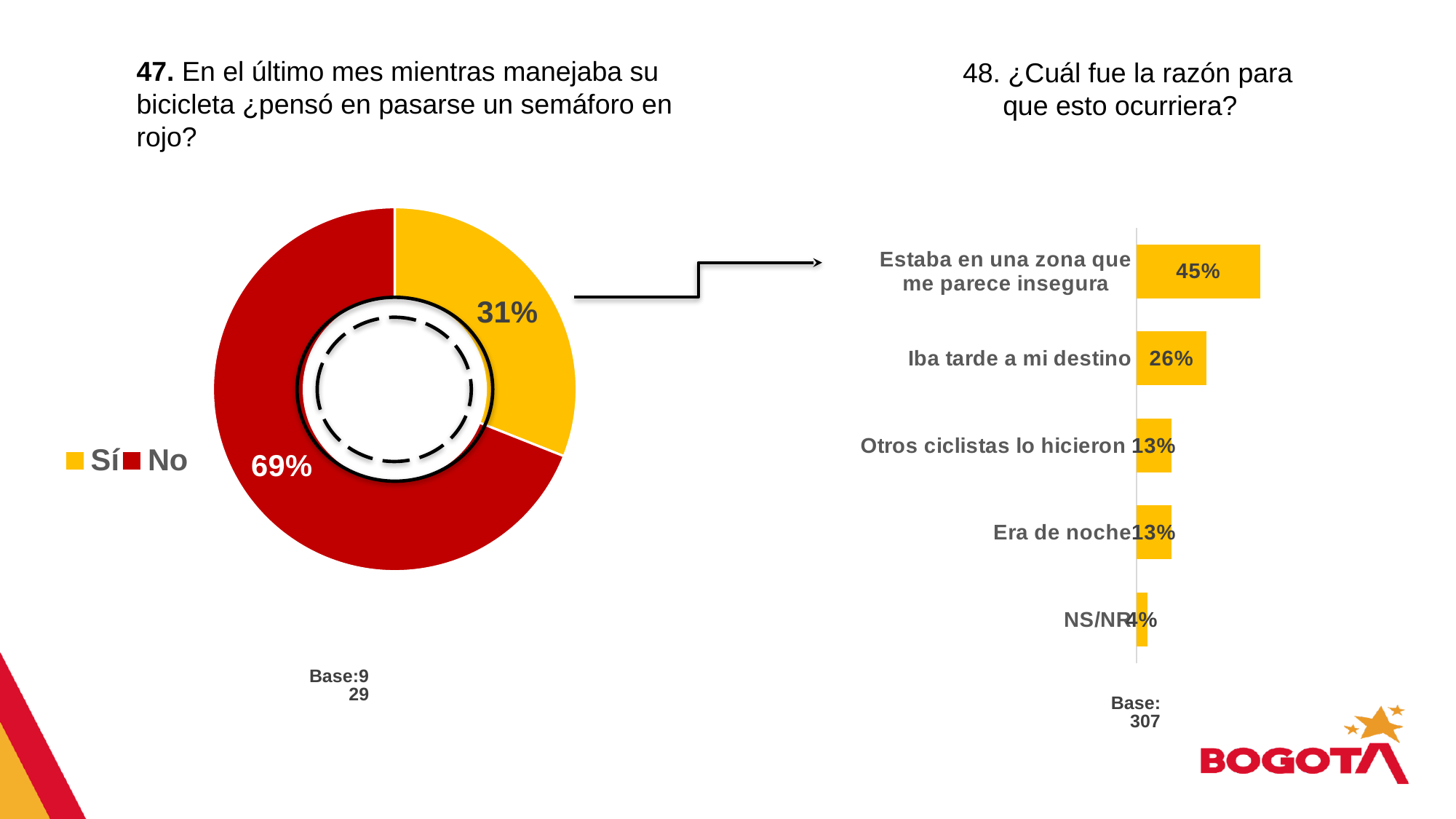
What kind of chart is used for question 48 on the right? Bar chart In the bar chart on the right (question 48), what is the difference between 'Estaba en una zona que me parece insegura' and 'Iba tarde a mi destino'? 19% In the bar chart on the right (question 48), which category has the highest value? Estaba en una zona que me parece insegura In the pie chart on the left (question 47), which answer has the larger share, 'Sí' or 'No'? No In the pie chart on the left (question 47), what percentage answered 'Sí'? 31% In the pie chart on the left (question 47), what percentage answered 'No'? 69% In the bar chart on the right (question 48), which category has the lowest value? NS/NR In the bar chart on the right (question 48), what is the value for 'Iba tarde a mi destino'? 26% In the pie chart on the left (question 47), what is the difference between the 'No' and 'Sí' shares? 38% In the bar chart on the right (question 48), what is the value for 'Estaba en una zona que me parece insegura'? 45% How many categories are shown in the bar chart on the right (question 48)? 5 How many entries does the legend of the pie chart on the left (question 47) list? 2